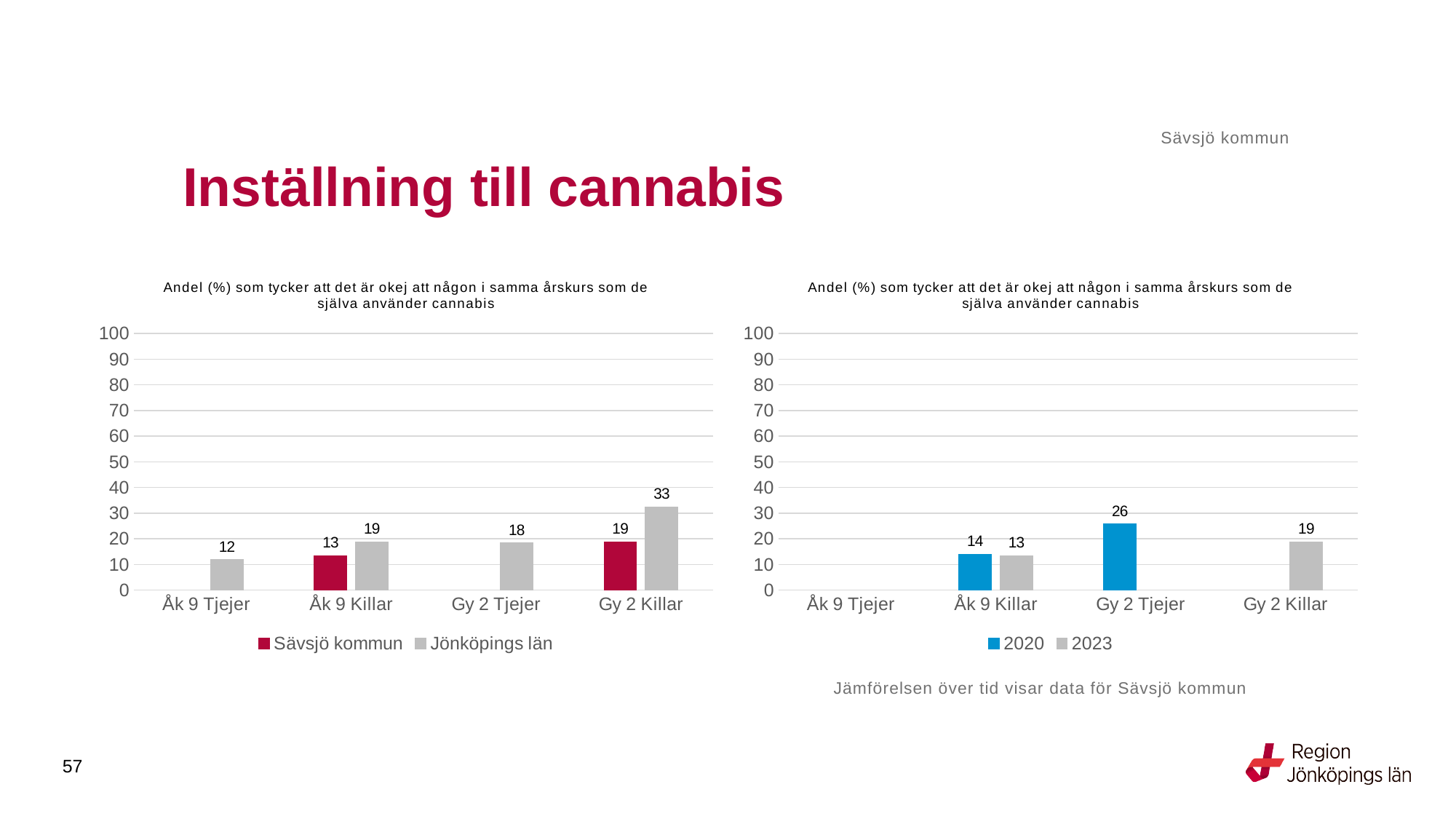
In the left chart, which is larger for Åk 9 Killar: Sävsjö kommun or Jönköpings län? Jönköpings län In the right chart, what is the difference between 2020 and 2023 for Åk 9 Killar? 1 In the right chart, what is the value for 2020 for Gy 2 Tjejer? 26 In the left chart, how many series does the legend list? 2 In the left chart, which category has the lowest value for Jönköpings län? Åk 9 Tjejer In the left chart, which category has the highest value for Jönköpings län? Gy 2 Killar In the left chart, what is the value for Sävsjö kommun for Åk 9 Killar? 13 In the left chart, what is the difference between Jönköpings län and Sävsjö kommun for Gy 2 Killar? 14 In the left chart, what is the value for Jönköpings län for Gy 2 Killar? 33 In the right chart, what is the value for 2023 for Gy 2 Killar? 19 What kind of chart is the right chart? Bar chart In the right chart, is the value for 2020 for Gy 2 Tjejer greater or less than 20? greater